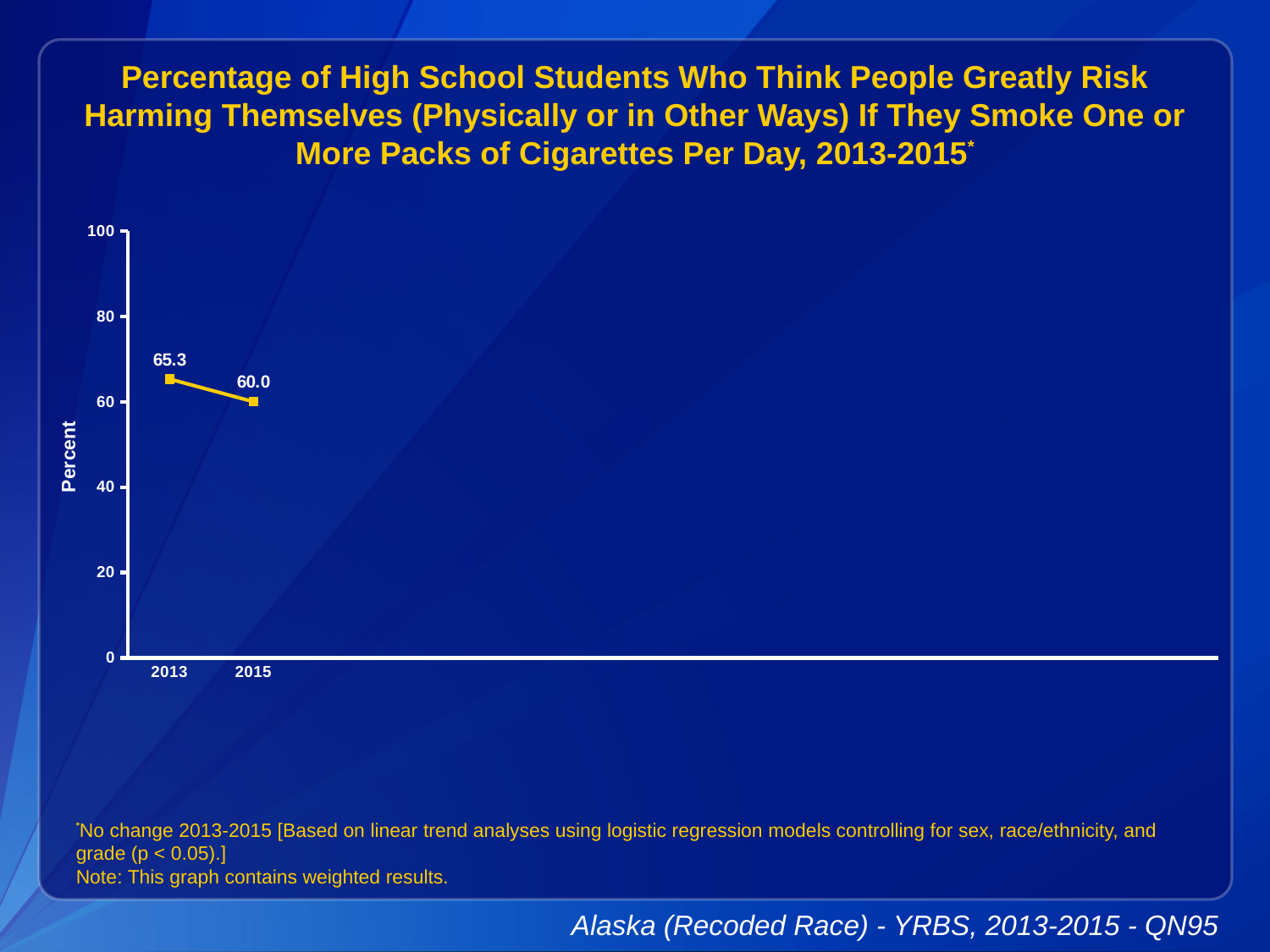
What kind of chart is shown on the slide? line chart Which year has the highest value? 2013 Is the value for 2015 greater or less than 40? greater Do the values rise or fall from 2013 to 2015? fall Which year has the lowest value? 2015 What is the value for 2015? 60.0 Which is larger, the value for 2013 or the value for 2015? 2013 Is the value for 2013 greater or less than 80? less What is the label on the vertical axis? Percent What is the difference between the 2013 and 2015 values? 5.3 How many data points are plotted on the chart? 2 What is the value for 2013? 65.3